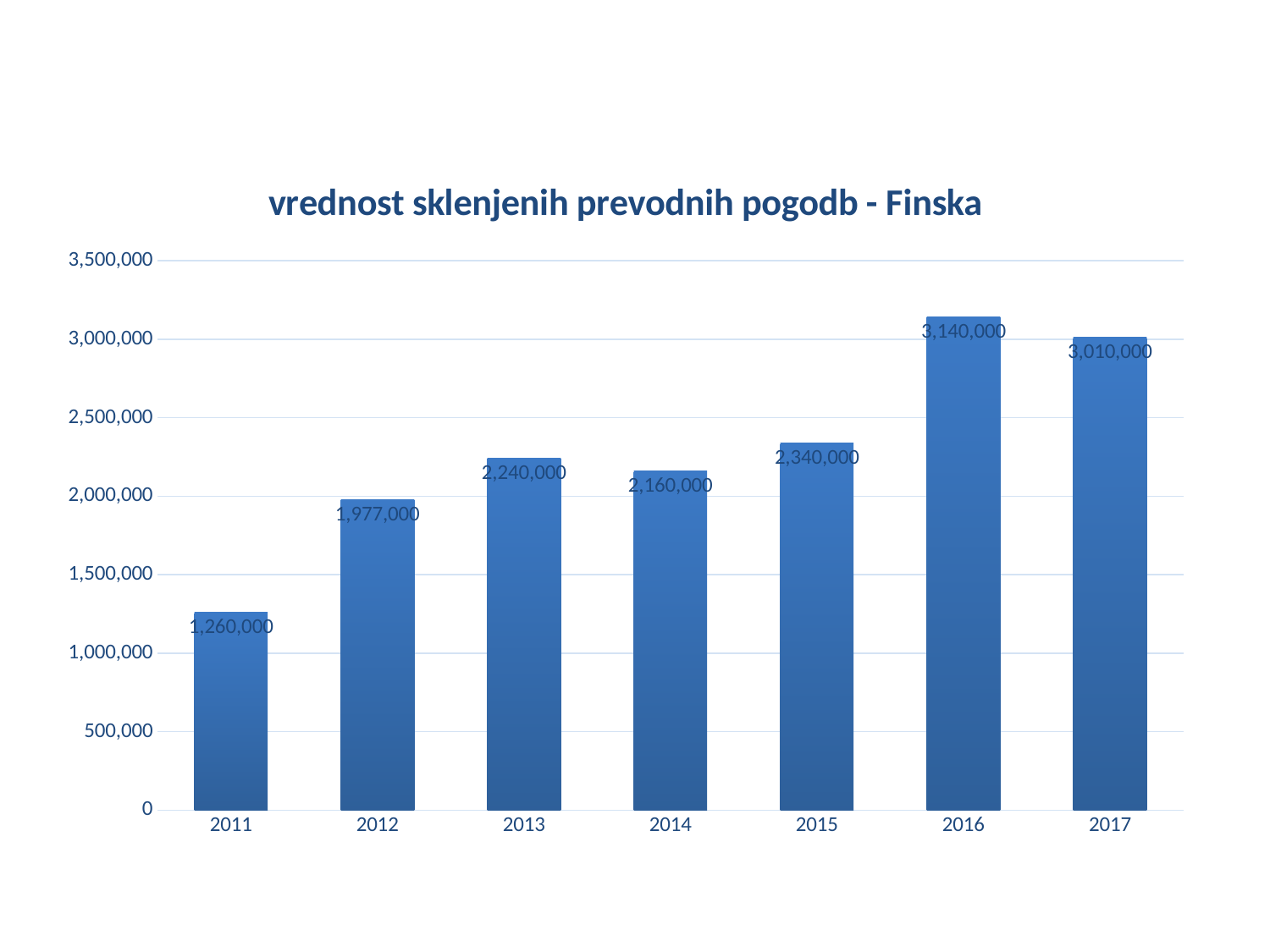
What is the value for 2017? 3,010,000 What is the title of the chart? vrednost sklenjenih prevodnih pogodb - Finska Which is larger, the value for 2013 or the value for 2014? 2013 What is the value for 2011? 1,260,000 Which year has the lowest value? 2011 Is the value for 2015 greater or less than 2,000,000? greater What is the difference between the values for 2016 and 2017? 130,000 What is the value for 2014? 2,160,000 Which year has the highest value? 2016 What kind of chart is shown on the slide? bar chart How many years are shown on the x axis? 7 What is the difference between the values for 2012 and 2011? 717,000